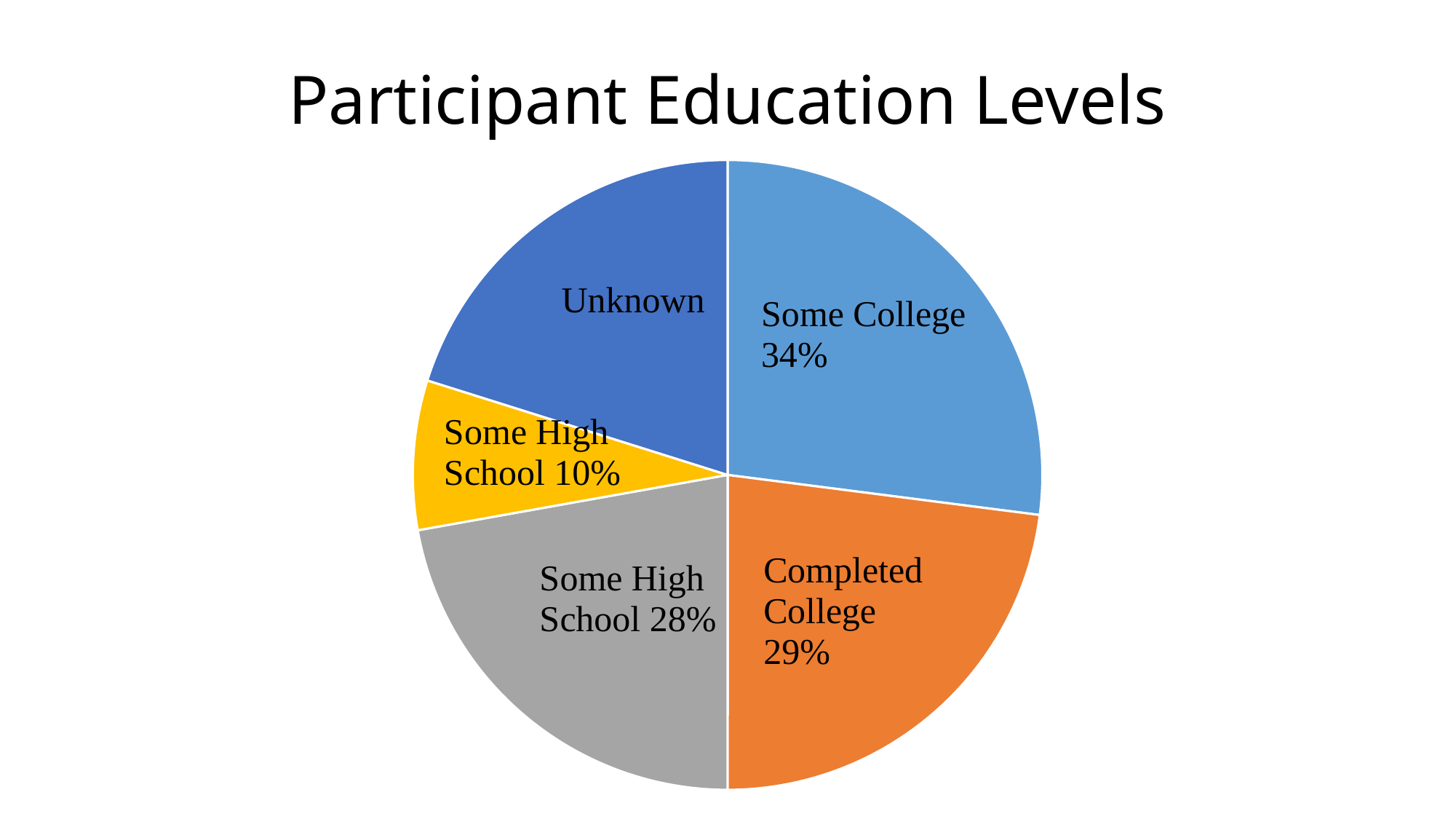
What percentage is shown on the grey Some High School slice? 28% Which slice of the pie is the smallest? Some High School 10% How many slices does the pie chart have? 5 By how many percentage points does Some College exceed Completed College? 5 What percentage is shown on the yellow Some High School slice? 10% What kind of chart is shown on the slide? pie chart Which slice of the pie is the largest? Some College What share of participants had Some College? 34% What is the title of the chart? Participant Education Levels What colour is the Completed College slice? orange Which is larger, the Some College slice or the Completed College slice? Some College What share of participants Completed College? 29%